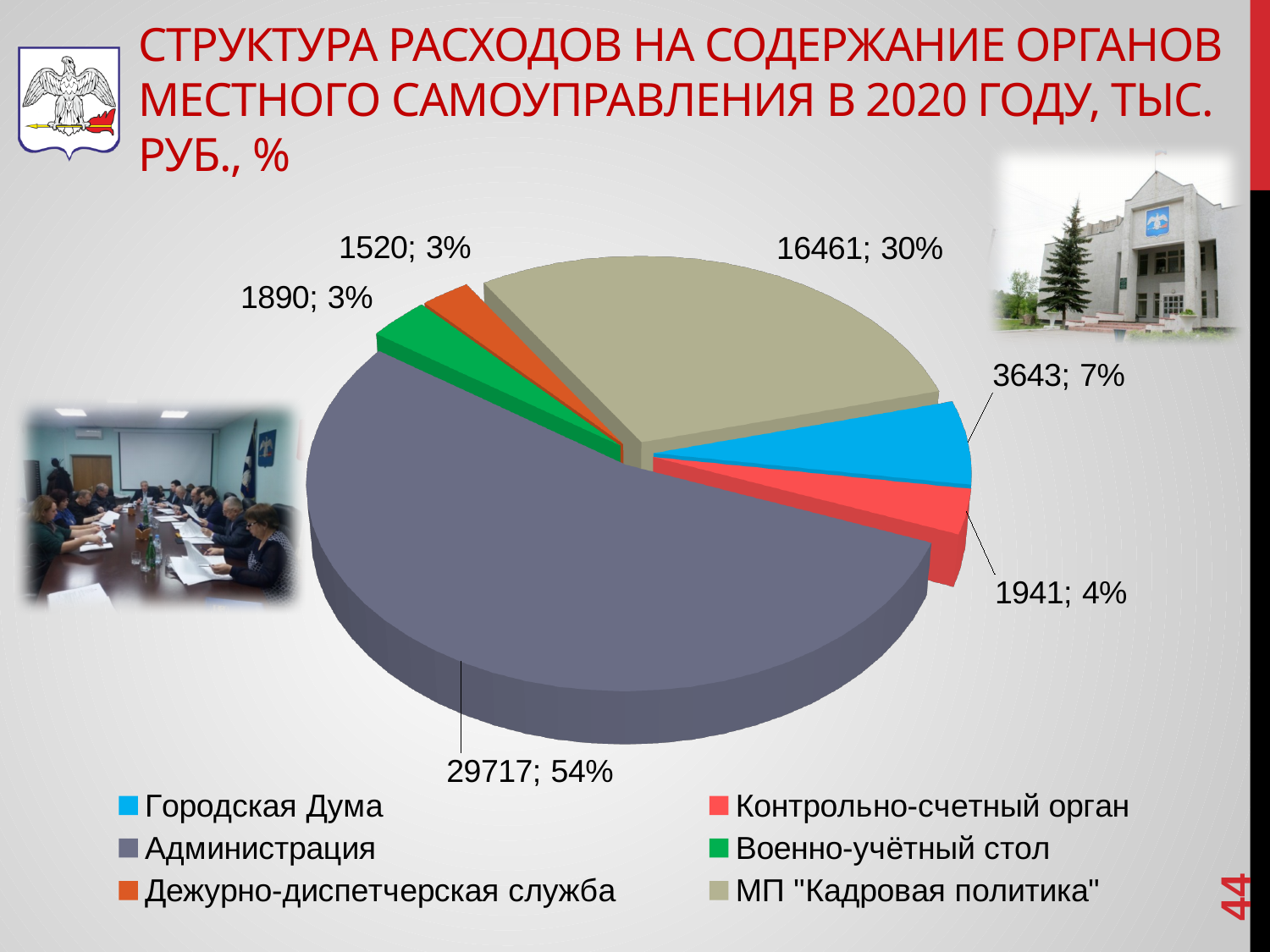
Which category has the largest slice? Администрация What value is shown for МП "Кадровая политика"? 16461 How many slices does the pie chart have? 6 Which is larger, the value for Городская Дума or the value for Контрольно-счетный орган? Городская Дума What value is shown for Контрольно-счетный орган? 1941 What share of the pie does Городская Дума take? 7% How many entries does the legend list? 6 What share of the pie does Администрация take? 54% What value is shown for Администрация? 29717 What is the difference between the values for Администрация and МП "Кадровая политика"? 13256 Which category has the smallest slice? Дежурно-диспетчерская служба What kind of chart is shown on the slide? pie chart